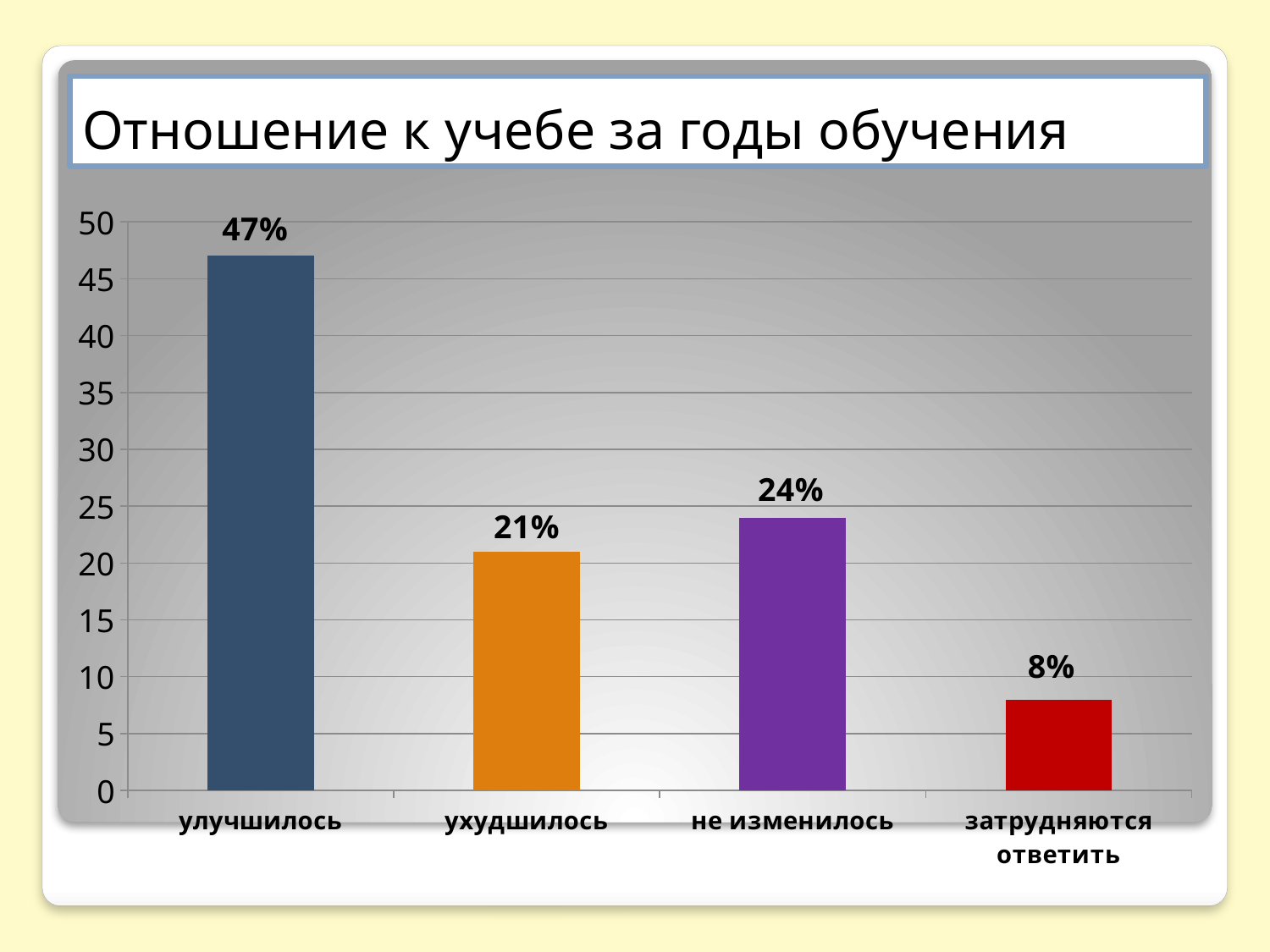
What is the value for ухудшилось? 21% Which category has the highest value? улучшилось What is the value for улучшилось? 47% What is the value for не изменилось? 24% What is the value for затрудняются ответить? 8% Which is larger, the value for ухудшилось or the value for не изменилось? не изменилось Is the value for улучшилось greater or less than 40? greater Which category has the lowest value? затрудняются ответить What kind of chart is shown on the slide? bar chart How many categories are shown on the x axis? 4 What is the difference between the values for улучшилось and не изменилось? 23% What is the title of the chart? Отношение к учебе за годы обучения